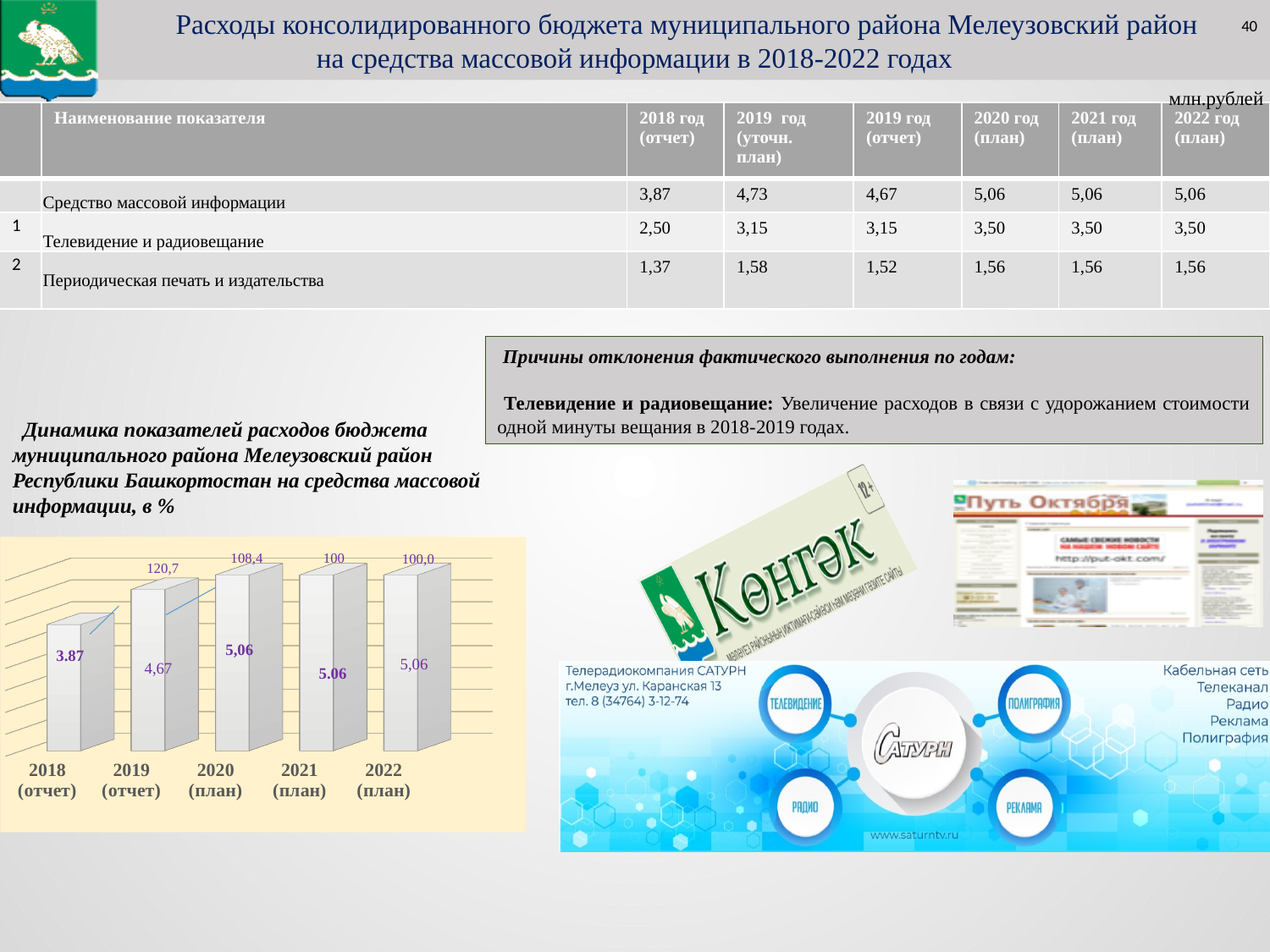
What is the value of the bar for 2022 (план) in the chart? 5,06 What is the value of the bar for 2018 (отчет) in the chart? 3.87 Which year has the lowest bar in the chart? 2018 (отчет) What is the value of the bar for 2020 (план) in the chart? 5,06 What is the difference between the bar values for 2019 (отчет) and 2018 (отчет) in the chart? 0,80 Which is larger in the chart: the bar for 2018 (отчет) or the bar for 2019 (отчет)? 2019 (отчет) What percentage label is shown above the 2019 (отчет) bar in the chart? 120,7 What kind of chart is shown on the slide? bar chart What percentage label is shown above the 2020 (план) bar in the chart? 108,4 What is the value of the bar for 2019 (отчет) in the chart? 4,67 Do the bar values rise or fall from 2018 to 2020 in the chart? rise How many year categories are shown on the x axis of the chart? 5